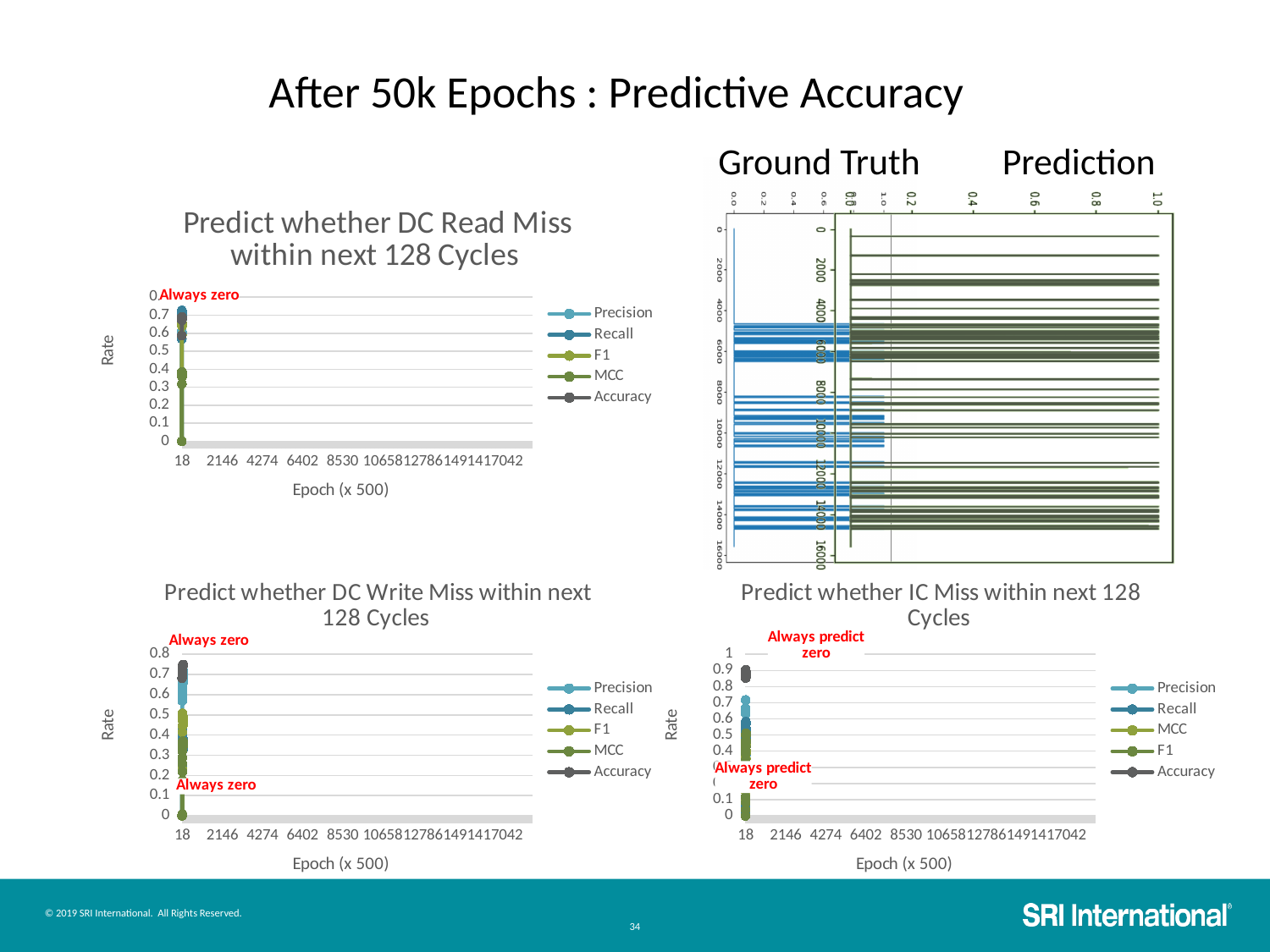
In the chart titled "Predict whether DC Write Miss within next 128 Cycles", what is the x-axis title? Epoch (x 500) In the chart titled "Predict whether IC Miss within next 128 Cycles", how many series does the legend list? 5 What kind of chart is "Predict whether DC Read Miss within next 128 Cycles"? Line chart In the chart titled "Predict whether DC Read Miss within next 128 Cycles", what is the y-axis title? Rate In the chart titled "Predict whether IC Miss within next 128 Cycles", are the Accuracy values at epoch 18 greater or less than 0.5? greater In the chart titled "Predict whether DC Read Miss within next 128 Cycles", how many series does the legend list? 5 What kind of chart is "Predict whether IC Miss within next 128 Cycles"? Line chart In the chart titled "Predict whether DC Write Miss within next 128 Cycles", how many series does the legend list? 5 In the chart titled "Predict whether DC Write Miss within next 128 Cycles", how many epoch tick labels are shown on the x axis? 9